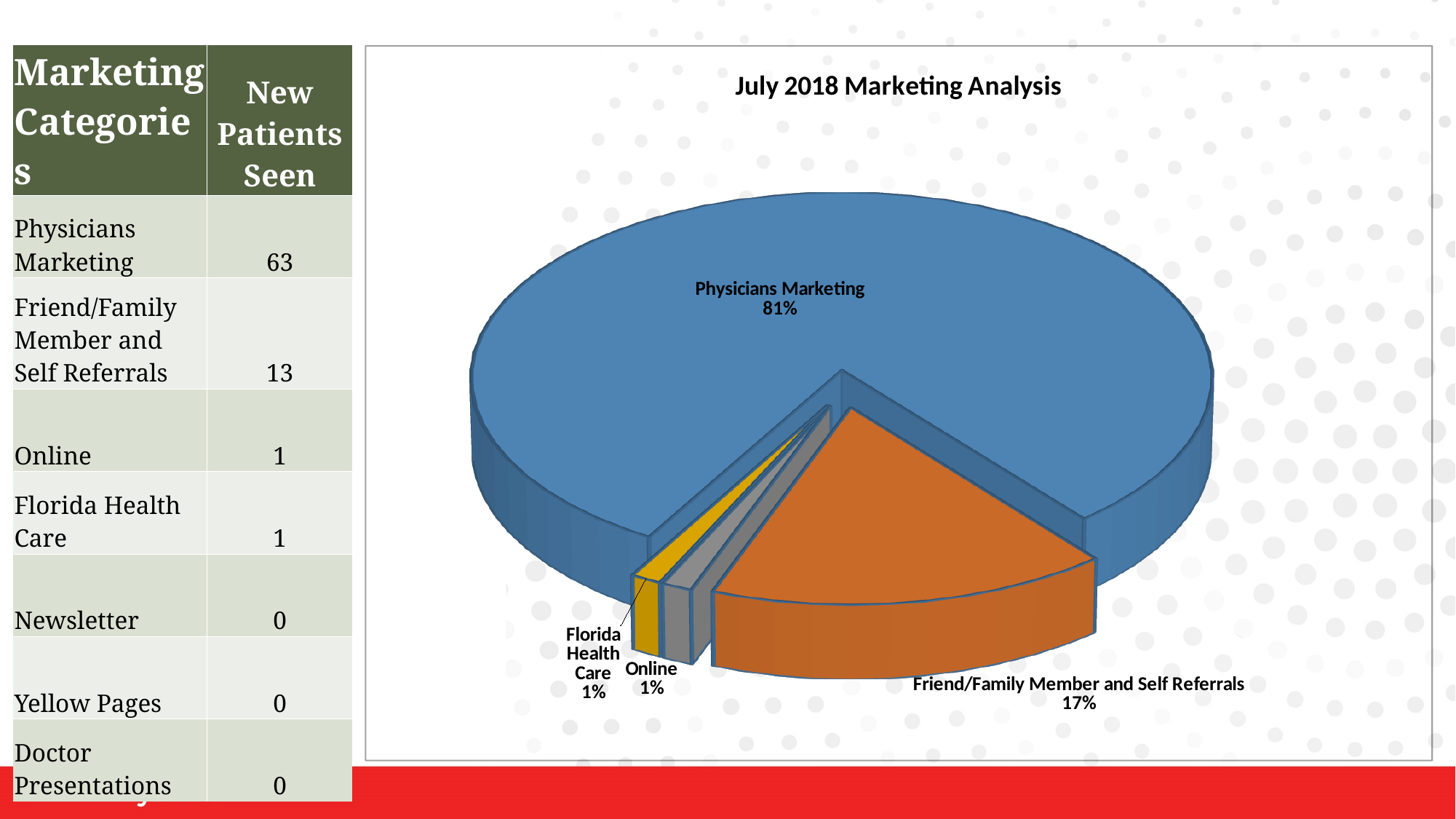
Which category has the largest slice of the pie? Physicians Marketing What is the title of the pie chart? July 2018 Marketing Analysis What kind of chart is shown on the slide? pie chart What share of the pie does Friend/Family Member and Self Referrals account for? 17% What share of the pie does Florida Health Care account for? 1% Is the share for Friend/Family Member and Self Referrals greater or less than 20%? less Which is larger in the pie chart, Physicians Marketing or Friend/Family Member and Self Referrals? Physicians Marketing How many labeled slices does the pie chart show? 4 What is the difference in percentage points between the Physicians Marketing slice and the Friend/Family Member and Self Referrals slice? 64 What share of the pie does Physicians Marketing account for? 81% What colour is the Physicians Marketing slice? blue